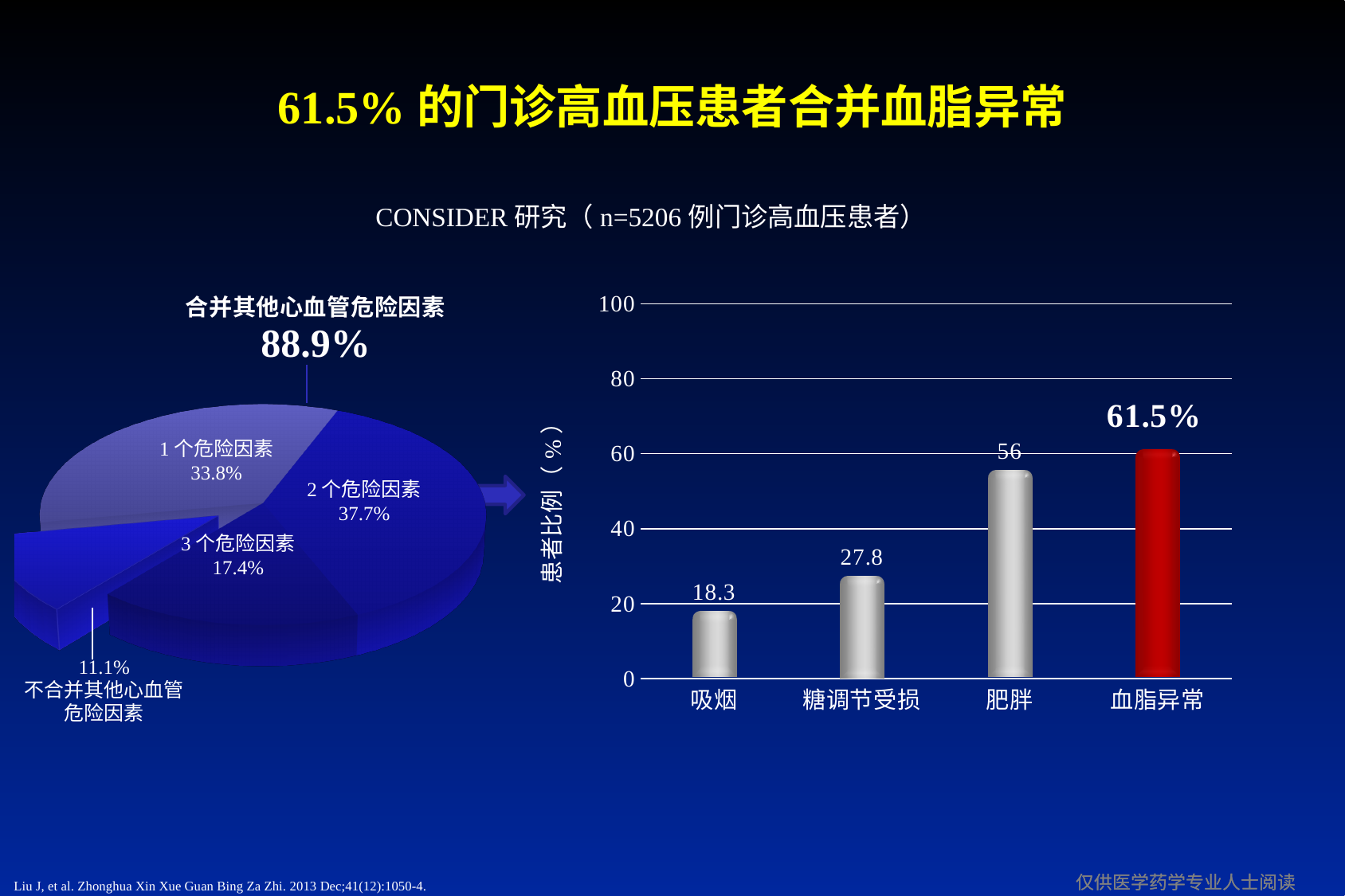
In the bar chart on the right, what is the value for 肥胖? 56 In the bar chart on the right, what is the value for 糖调节受损? 27.8 In the bar chart on the right, how many categories are shown on the x axis? 4 In the pie chart on the left, what share is labelled for 不合并其他心血管危险因素? 11.1% In the bar chart on the right, what is the value for 吸烟? 18.3 In the bar chart on the right, what is the difference between the values for 肥胖 and 糖调节受损? 28.2 In the bar chart on the right, which category has the highest value? 血脂异常 In the bar chart on the right, do the values rise or fall from left to right along the x axis? rise In the pie chart on the left, which is larger: the slice for 1 个危险因素 or the slice for 3 个危险因素? 1 个危险因素 In the pie chart on the left, what share is labelled for 2 个危险因素? 37.7% What kind of chart is shown on the left side of the slide? pie chart In the bar chart on the right, which category has the lowest value? 吸烟